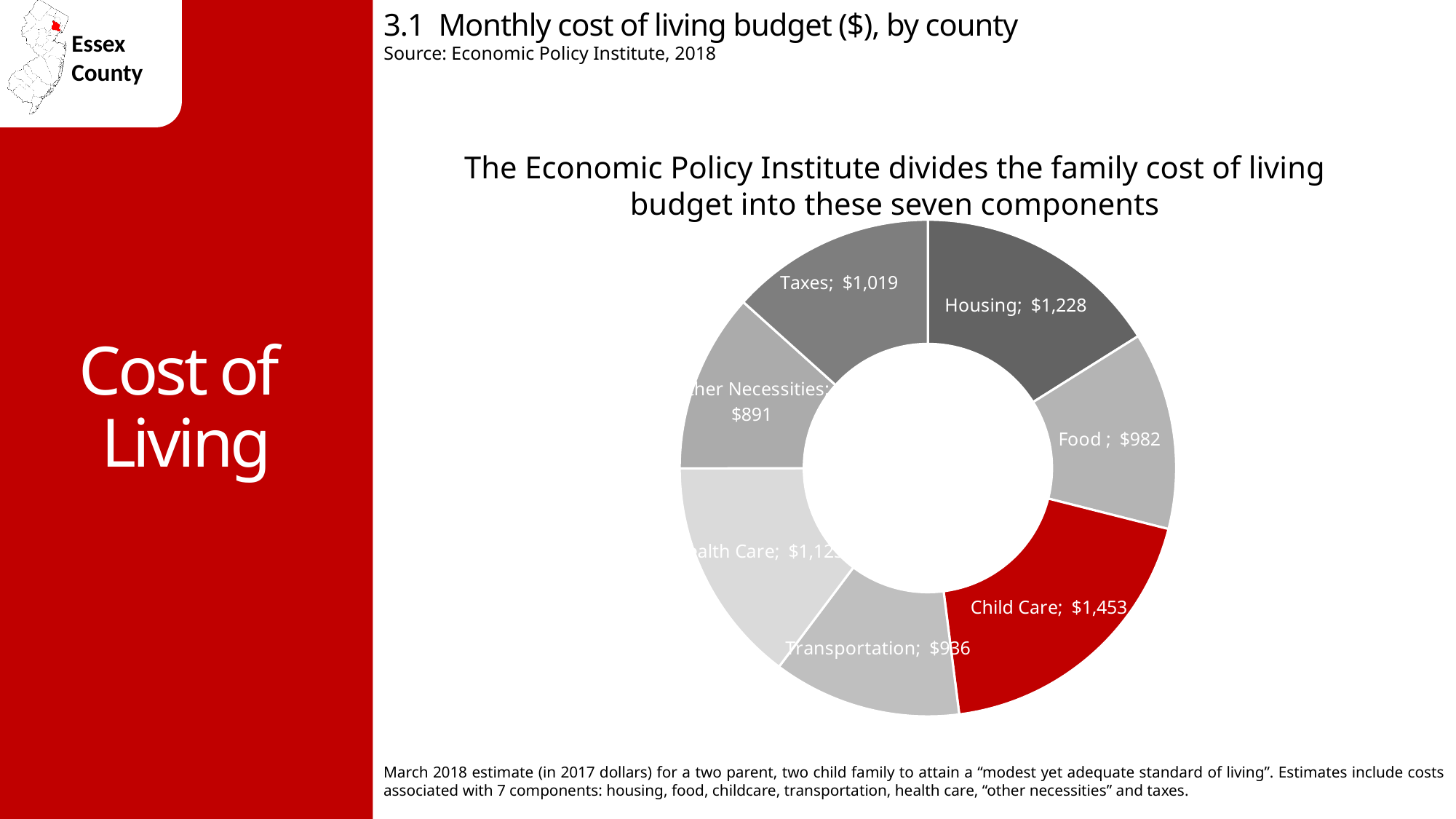
What is the monthly cost for Housing? $1,228 What is the monthly cost for Taxes? $1,019 What is the monthly cost for Food? $982 Which is larger, the monthly cost for Food or for Taxes? Taxes Which component's slice is coloured red in the chart? Child Care What is the monthly cost for Child Care? $1,453 How many components (slices) does the chart divide the monthly cost of living budget into? 7 What is the monthly cost for Other Necessities? $891 How much more is the monthly cost for Housing than for Taxes? $209 What kind of chart is shown on the slide? doughnut (pie) chart Which component has the lowest monthly cost? Other Necessities Which component has the highest monthly cost? Child Care